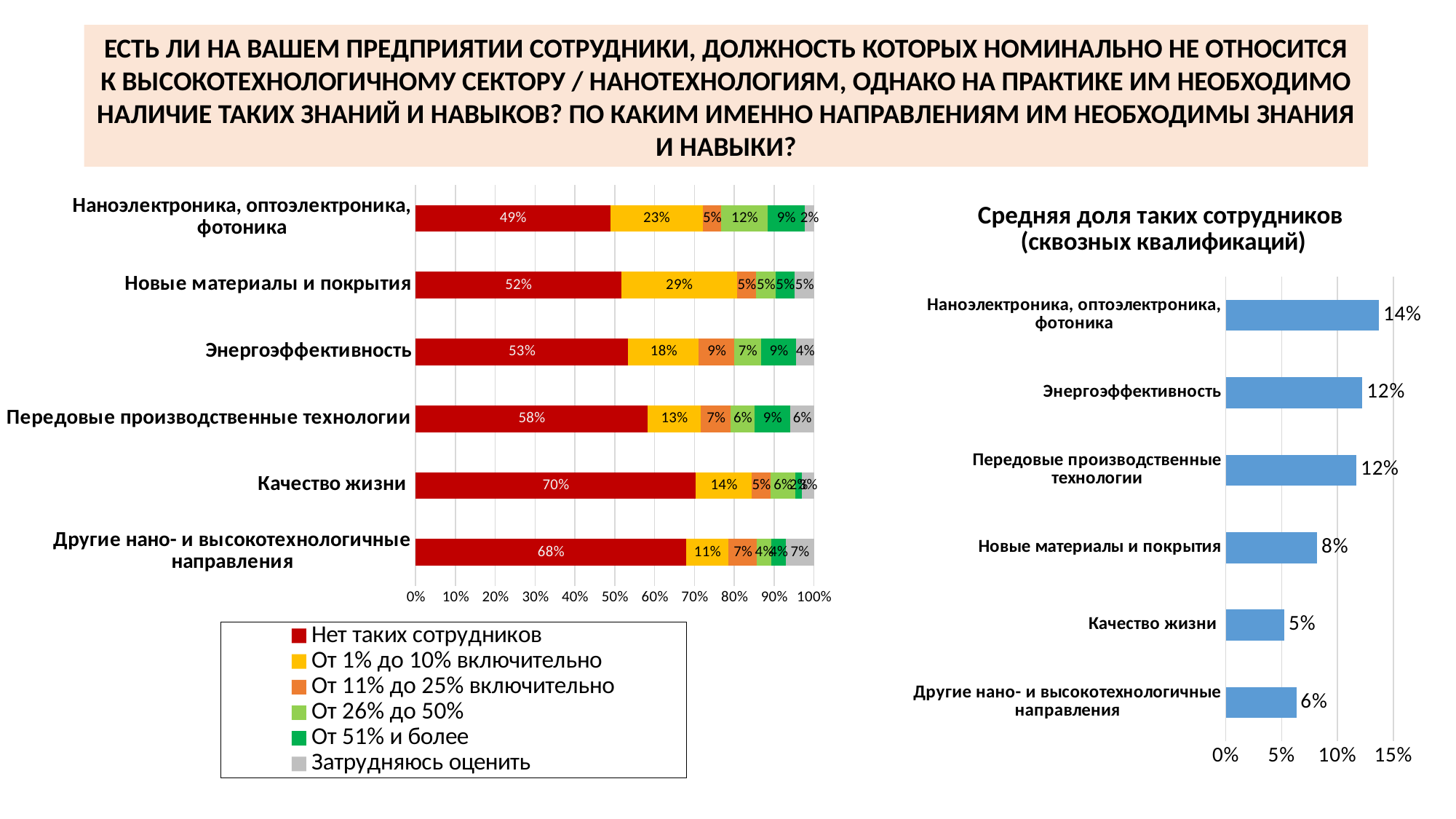
In the stacked bar chart on the left, which category has the highest value for 'Нет таких сотрудников'? Качество жизни What type of chart is the right chart titled 'Средняя доля таких сотрудников (сквозных квалификаций)'? Bar chart In the stacked bar chart on the left, what is the value of 'От 1% до 10% включительно' for 'Новые материалы и покрытия'? 29% In the right chart titled 'Средняя доля таких сотрудников (сквозных квалификаций)', what is the value for 'Наноэлектроника, оптоэлектроника, фотоника'? 14% In the stacked bar chart on the left, what is the difference between the 'Нет таких сотрудников' values for 'Качество жизни' and 'Наноэлектроника, оптоэлектроника, фотоника'? 21% In the stacked bar chart on the left, which has the larger value for 'Нет таких сотрудников': 'Энергоэффективность' or 'Передовые производственные технологии'? Передовые производственные технологии In the right chart titled 'Средняя доля таких сотрудников (сквозных квалификаций)', how many categories are shown? 6 In the stacked bar chart on the left, how many series does the legend list? 6 In the right chart titled 'Средняя доля таких сотрудников (сквозных квалификаций)', what is the difference between the values for 'Наноэлектроника, оптоэлектроника, фотоника' and 'Новые материалы и покрытия'? 6% In the right chart titled 'Средняя доля таких сотрудников (сквозных квалификаций)', which category has the highest value? Наноэлектроника, оптоэлектроника, фотоника In the stacked bar chart on the left, what is the value of 'Нет таких сотрудников' for 'Качество жизни'? 70% In the right chart titled 'Средняя доля таких сотрудников (сквозных квалификаций)', which category has the lowest value? Качество жизни